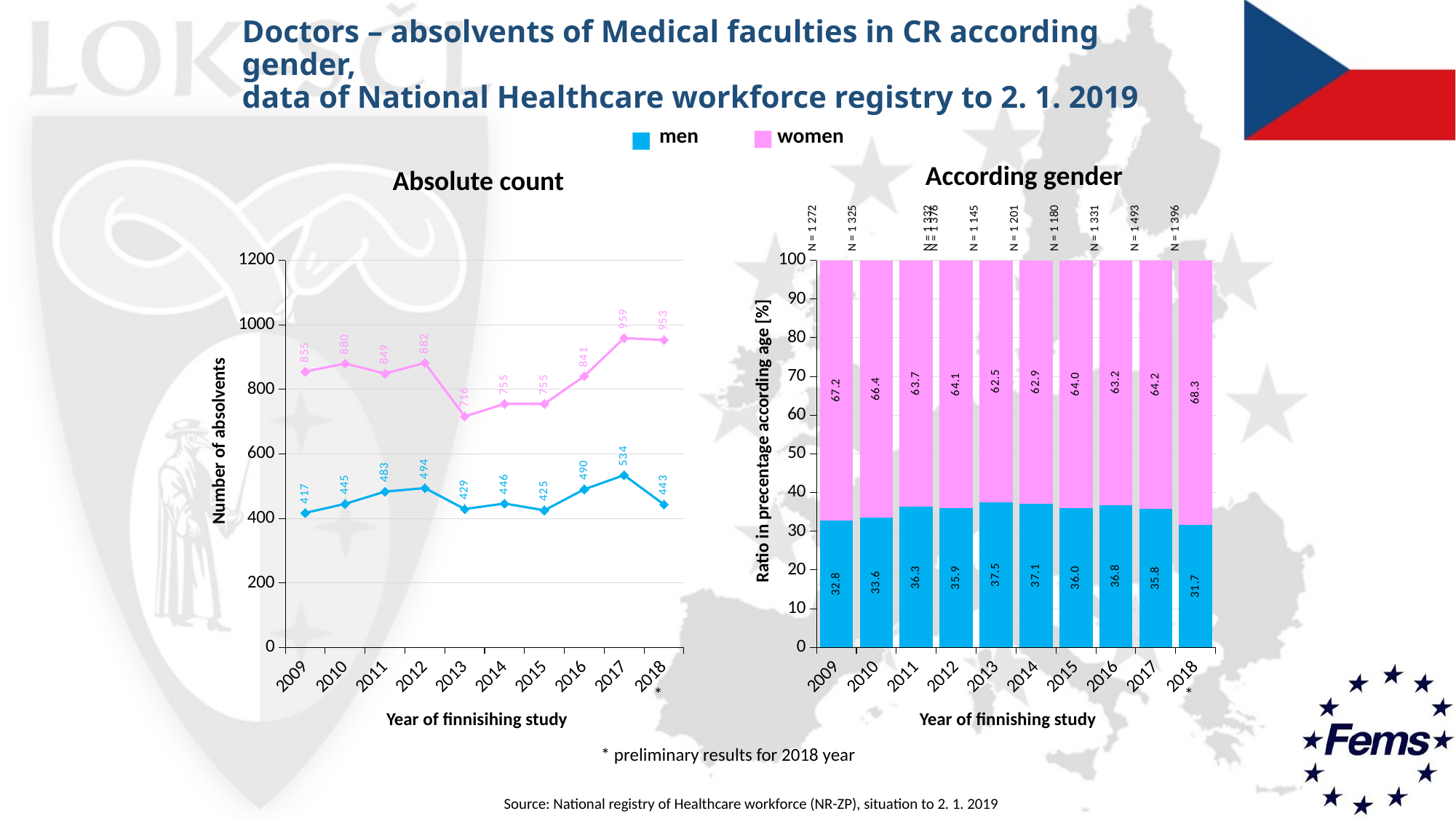
In the 'According gender' chart, what percentage of absolvents in 2018 were men? 31.7 In the 'Absolute count' chart, is the value for women in 2013 greater or less than 800? less What kind of chart is the 'Absolute count' chart? line chart How many series does the legend list? 2 In the 'According gender' chart, which year has the highest share of women? 2018 In the 'According gender' chart, which year has the highest share of men? 2013 In the 'Absolute count' chart, what is the difference between women and men absolvents in 2009? 438 In the 'According gender' chart, what is the N value shown above the 2017 bar? N = 1 493 In the 'Absolute count' chart, how many women absolvents were there in 2017? 959 In the 'Absolute count' chart, which year has the lowest value for women? 2013 In the 'Absolute count' chart, how many men absolvents were there in 2012? 494 In the 'Absolute count' chart, which year has the highest value for men? 2017